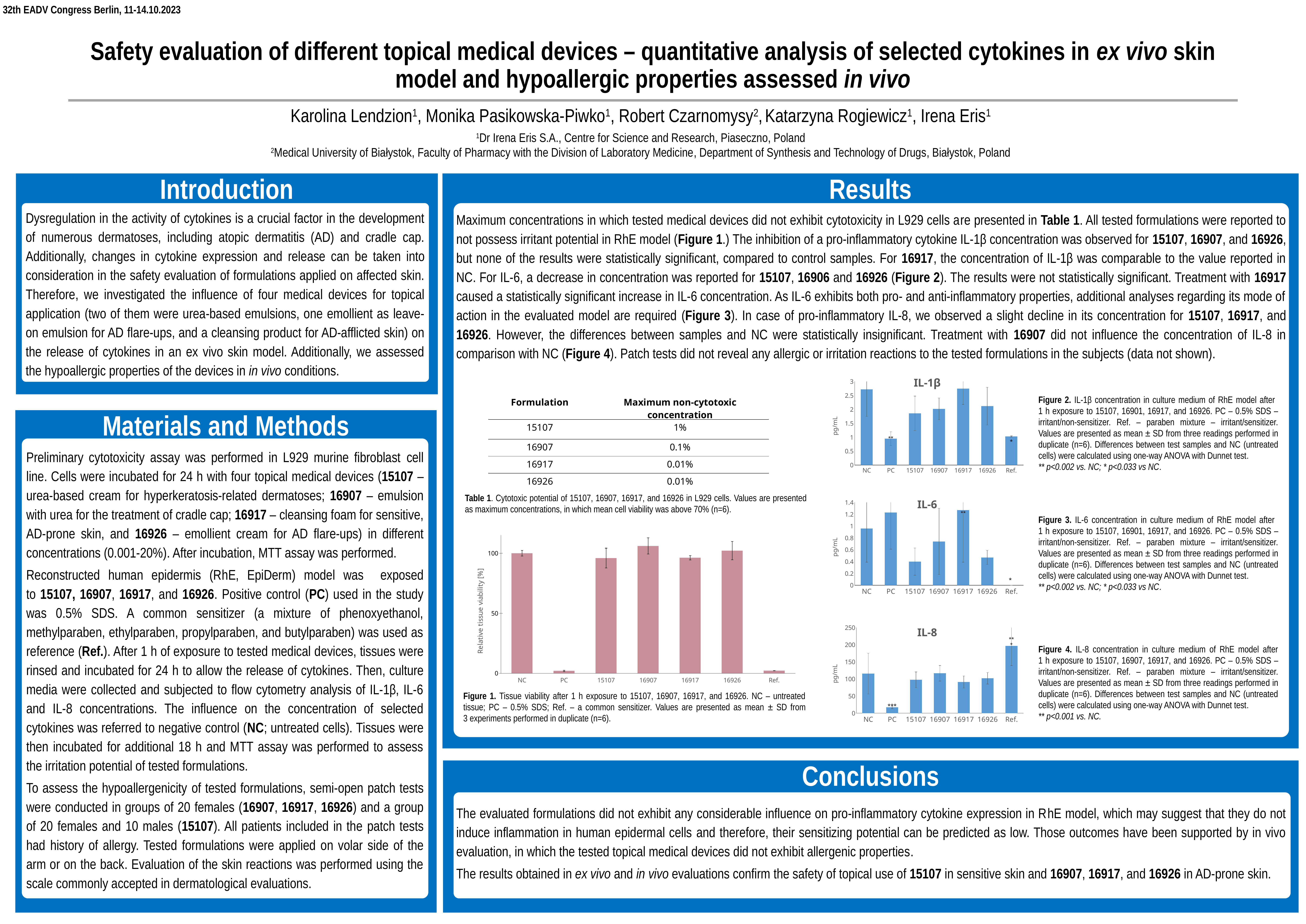
In Figure 1 (Tissue viability), is the value for PC greater or less than 50? less How many categories are shown on the x axis of the IL-8 chart? 7 In the IL-8 chart, is the value for Ref. greater or less than 150? greater In the IL-6 chart, which is larger, the value for 16917 or the value for 15107? 16917 In the IL-6 chart, which category has the lowest value? Ref. What is the y-axis label of Figure 1 (Tissue viability)? Relative tissue viability [%] In the IL-8 chart, which category has the highest value? Ref. In the IL-1β chart, is the value for 15107 greater or less than 1.5? greater In the IL-8 chart, which category has the lowest value? PC What kind of chart is Figure 1 (Tissue viability)? bar chart